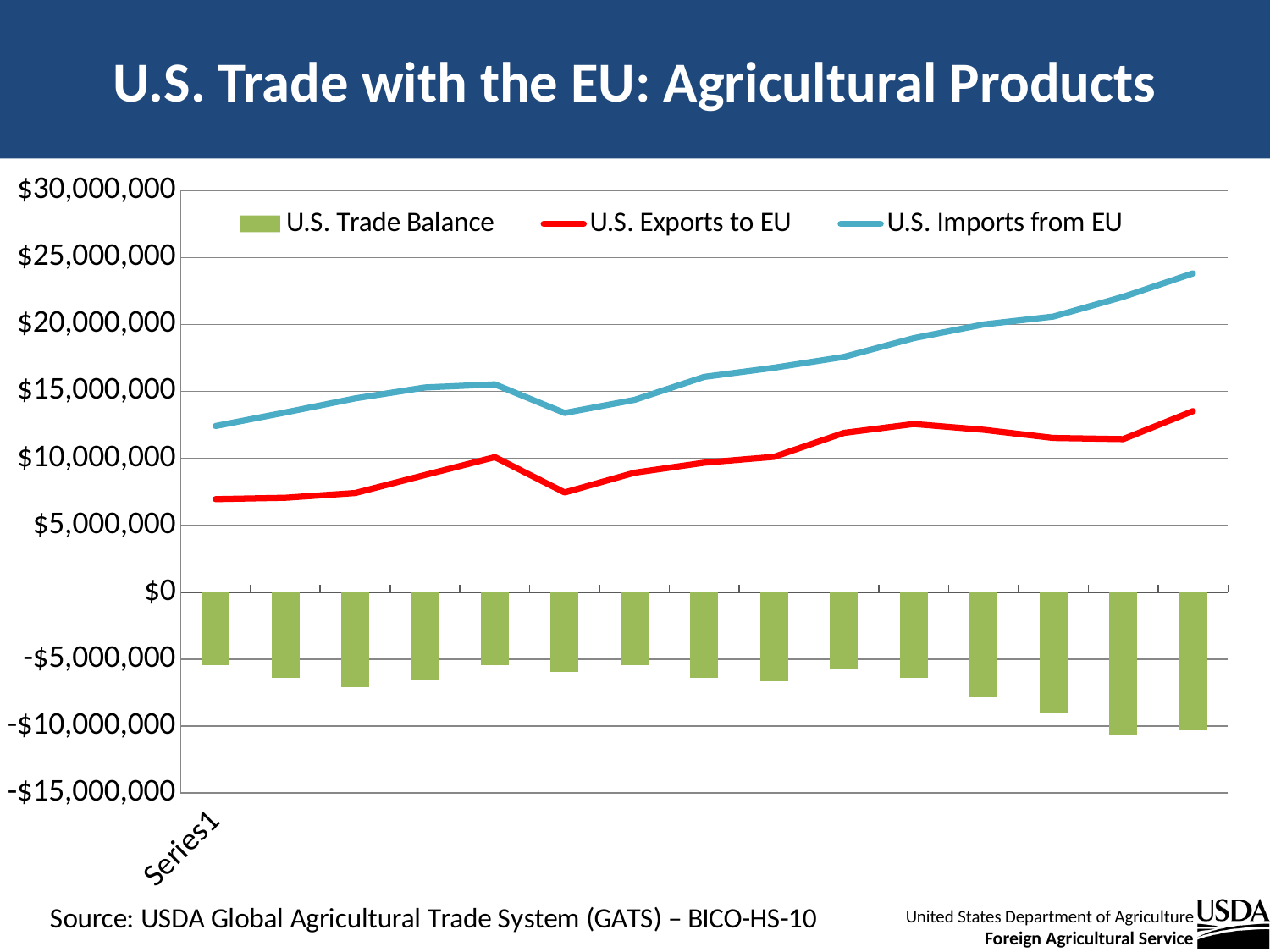
Is the last (rightmost) value of the U.S. Exports to EU line greater or less than $10,000,000? greater What is the title of the chart on the slide? U.S. Trade with the EU: Agricultural Products Which series in the chart is drawn as bars rather than a line? U.S. Trade Balance How many series does the chart's legend list? 3 Is the last (rightmost) value of the U.S. Imports from EU line greater or less than $20,000,000? greater How many U.S. Trade Balance bars are plotted in the chart? 15 Does the U.S. Exports to EU line generally rise or fall from left to right? rise Are all of the U.S. Trade Balance bars in the chart above or below $0? below Does the U.S. Imports from EU line generally rise or fall from left to right? rise Which series is higher at every point along the x axis, U.S. Exports to EU or U.S. Imports from EU? U.S. Imports from EU